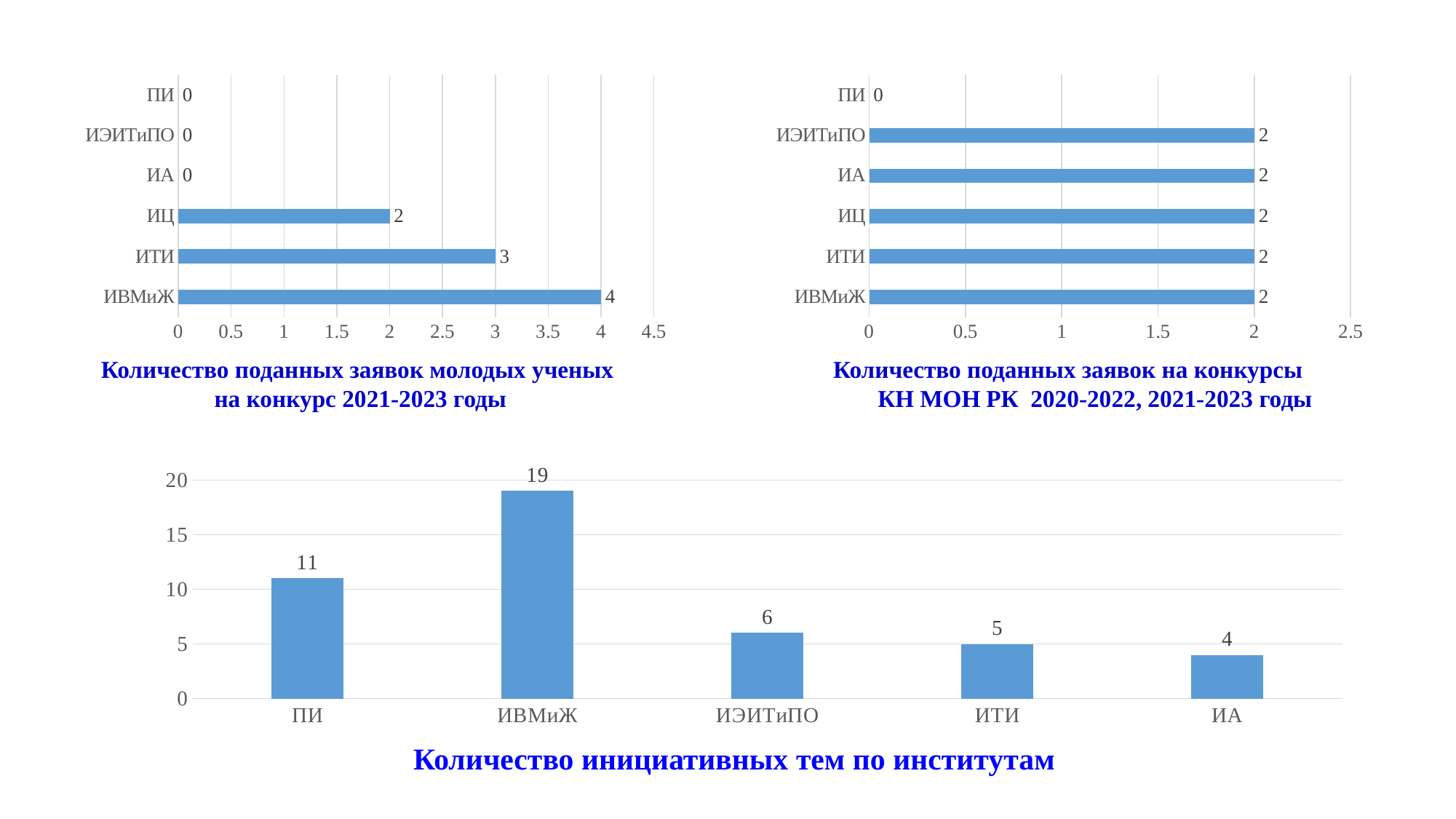
In the top-right chart (Количество поданных заявок на конкурсы КН МОН РК 2020-2022, 2021-2023 годы), which category has the lowest value? ПИ In the top-left chart (Количество поданных заявок молодых ученых на конкурс 2021-2023 годы), how many categories are shown? 6 In the bottom chart (Количество инициативных тем по институтам), which is larger, the value for ИТИ or the value for ИА? ИТИ In the bottom chart (Количество инициативных тем по институтам), what is the value for ИЭИТиПО? 6 In the bottom chart (Количество инициативных тем по институтам), which institute has the lowest value? ИА What kind of chart is the bottom chart (Количество инициативных тем по институтам)? Bar chart In the top-right chart (Количество поданных заявок на конкурсы КН МОН РК 2020-2022, 2021-2023 годы), what is the value for ИТИ? 2 In the bottom chart (Количество инициативных тем по институтам), what is the difference between the values for ИВМиЖ and ПИ? 8 In the bottom chart (Количество инициативных тем по институтам), which institute has the highest value? ИВМиЖ In the top-left chart (Количество поданных заявок молодых ученых на конкурс 2021-2023 годы), what is the difference between the values for ИВМиЖ and ИЦ? 2 In the top-left chart (Количество поданных заявок молодых ученых на конкурс 2021-2023 годы), what is the value for ИВМиЖ? 4 In the top-left chart (Количество поданных заявок молодых ученых на конкурс 2021-2023 годы), which category has the highest value? ИВМиЖ